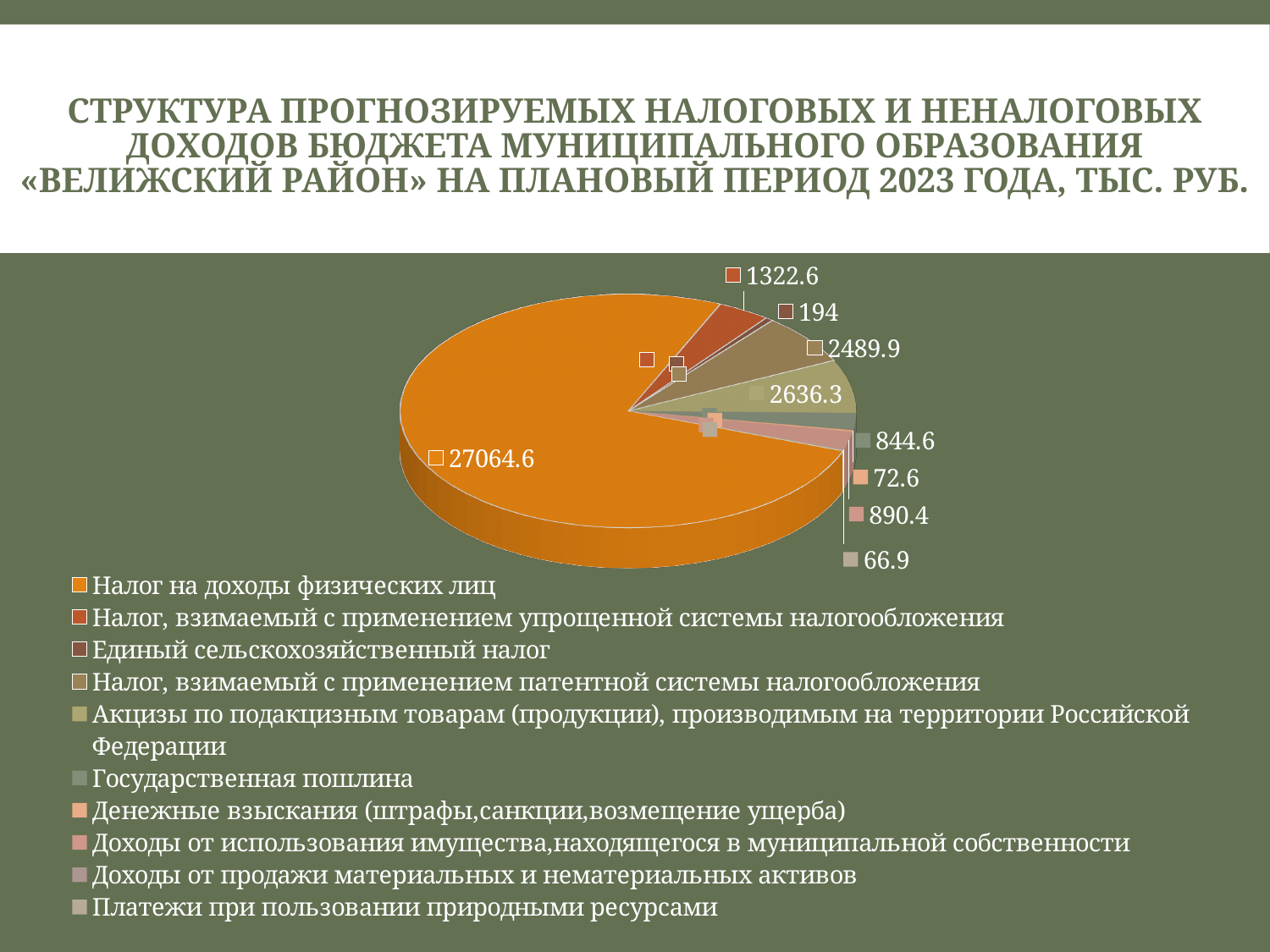
What is the value shown for Налог на доходы физических лиц? 27064.6 What is the value of the largest slice of the pie chart? 27064.6 What is the difference between the slices labelled 2636.3 and 2489.9? 146.4 What is the smallest value labelled on the pie chart? 66.9 In what units are the values in the chart expressed, according to the slide title? тыс. руб. What is the value shown for Налог, взимаемый с применением упрощенной системы налогообложения? 1322.6 Which is larger, the slice labelled 1322.6 or the slice labelled 890.4? 1322.6 What is the difference between the largest slice (27064.6) and the slice labelled 1322.6? 25742 What kind of chart is shown on the slide? pie chart How many categories does the legend of the pie chart list? 10 Which is larger, the slice labelled 844.6 or the slice labelled 890.4? 890.4 How many data labels are printed on the pie chart? 9